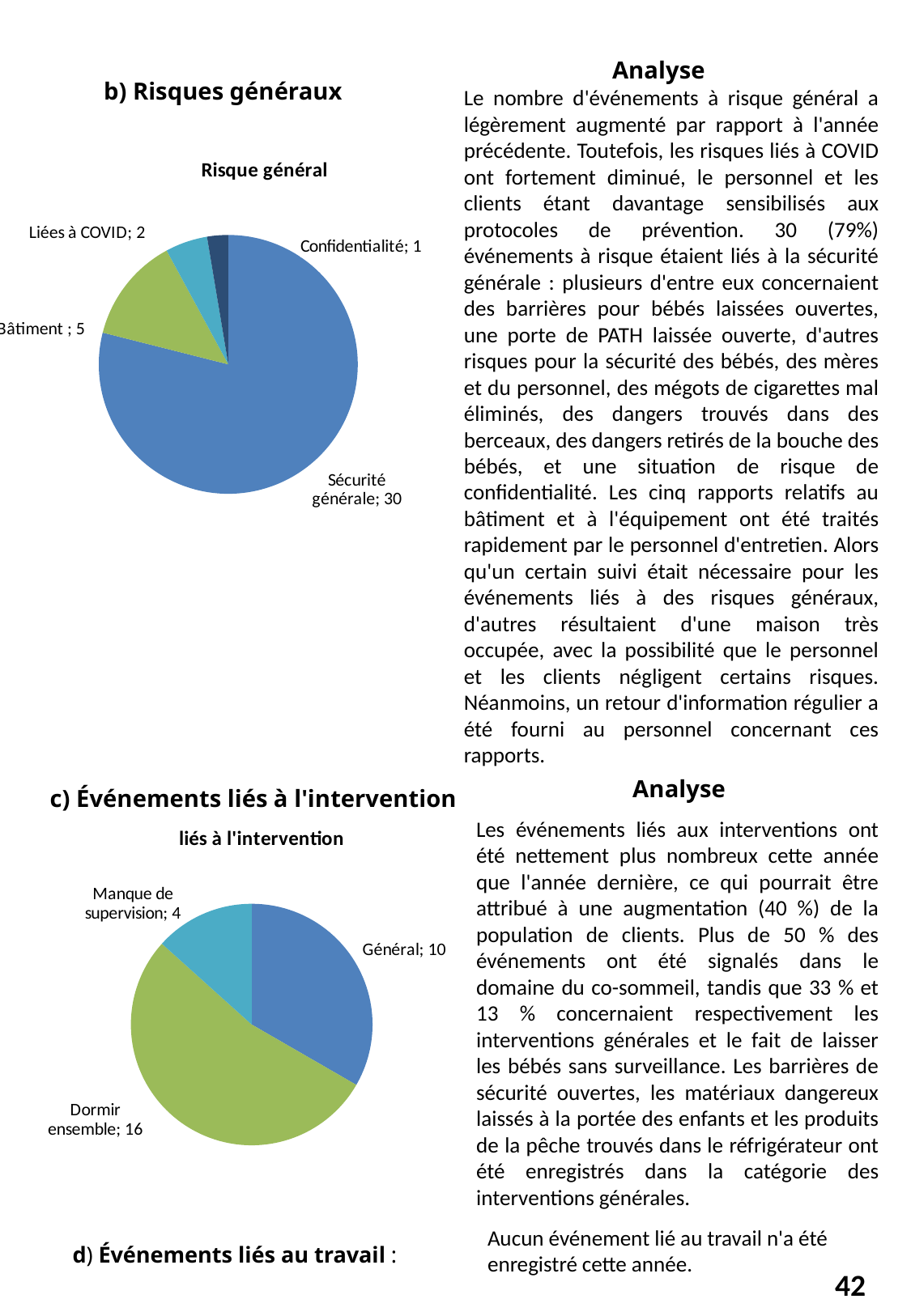
In the 'liés à l'intervention' chart, what is the value for Dormir ensemble? 16 What type of chart is 'Risque général'? Pie chart In the 'Risque général' chart, which category has the smallest value? Confidentialité In the 'Risque général' chart, which category has the largest value? Sécurité générale How many categories does the 'Risque général' pie chart show? 4 In the 'Risque général' chart, what is the difference between Sécurité générale and Bâtiment? 25 In the 'liés à l'intervention' chart, what is the difference between Dormir ensemble and Général? 6 In the 'Risque général' chart, what is the value for Bâtiment? 5 In the 'Risque général' chart, what is the value for Sécurité générale? 30 How many categories does the 'liés à l'intervention' pie chart show? 3 In the 'liés à l'intervention' chart, which is larger: Général or Manque de supervision? Général